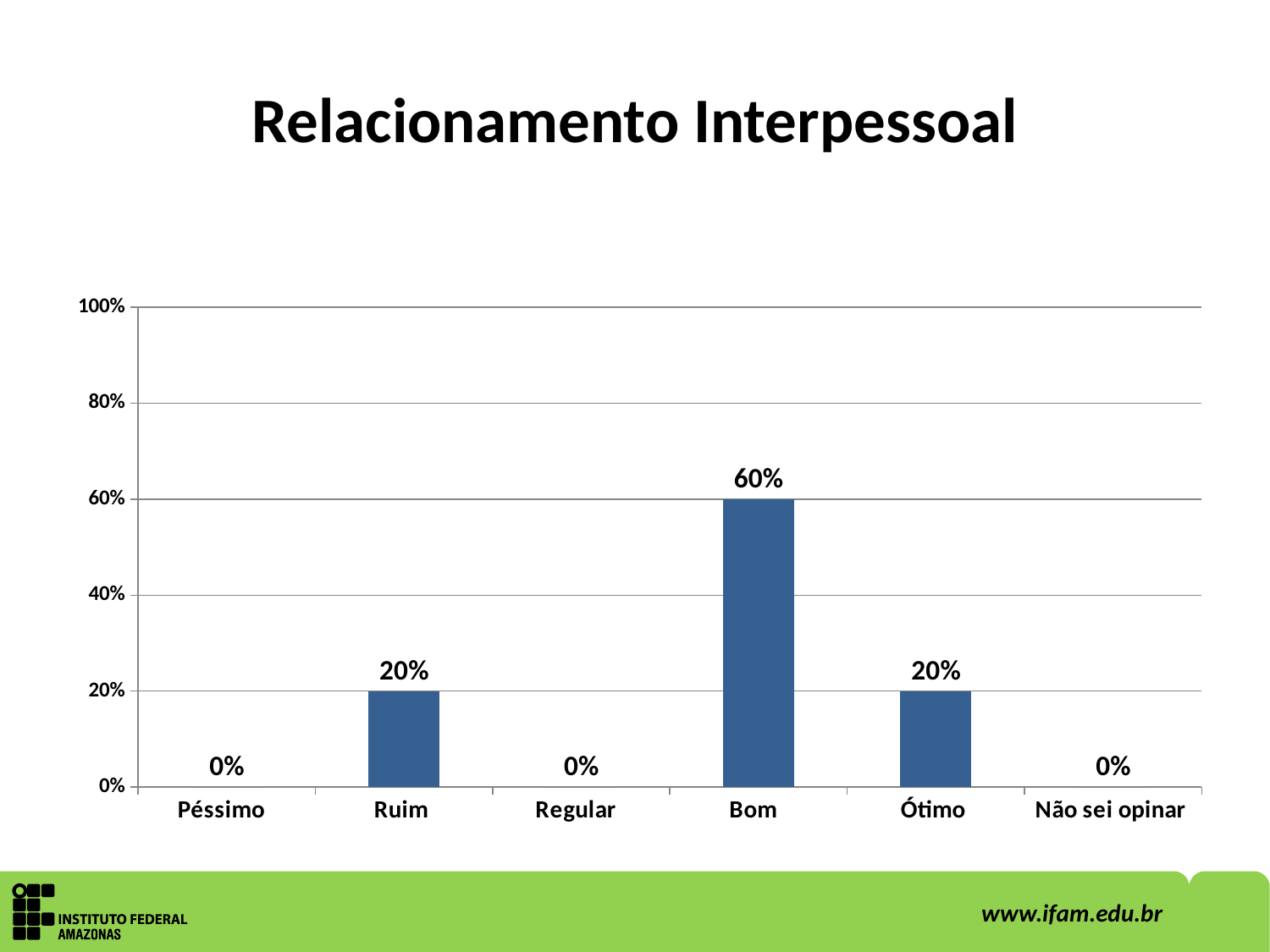
Is the value for Bom greater or less than 40%? greater What is the difference between the values for Bom and Ótimo? 40% How many categories have a value of 0%? 3 What is the title of the slide? Relacionamento Interpessoal Which category has the highest value? Bom What is the value for Não sei opinar? 0% Which is larger, the value for Ruim or the value for Bom? Bom What is the value for Ruim? 20% What is the value for Regular? 0% What is the value for Bom? 60% How many categories are shown on the x axis? 6 What kind of chart is shown on the slide? bar chart